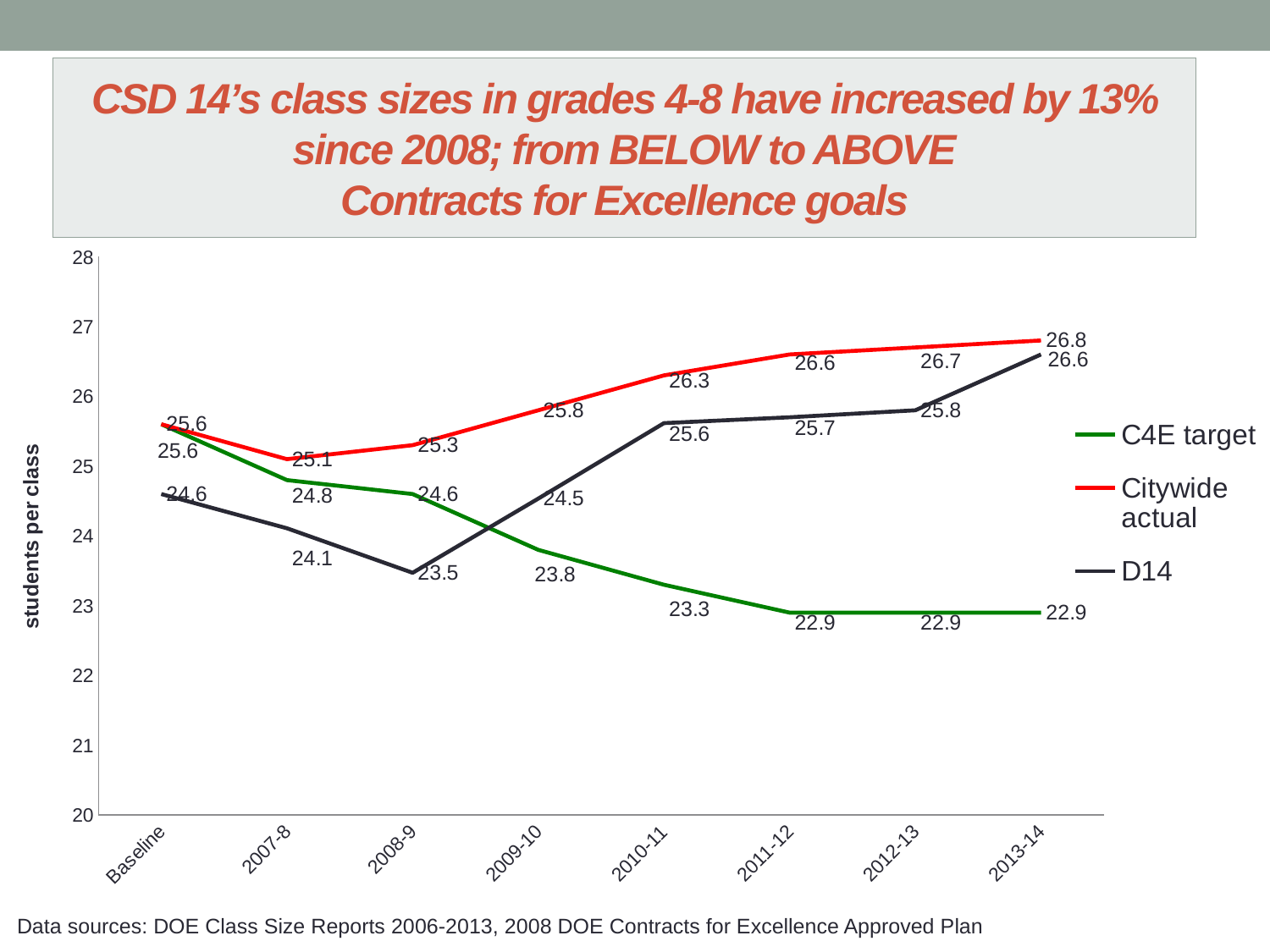
What is the C4E target value for 2009-10? 23.8 In which year is the D14 value lowest? 2008-9 What is the D14 value for 2013-14? 26.6 What kind of chart is shown on the slide? line chart How many points along the x axis does each line have? 8 In 2010-11, which is larger: Citywide actual or D14? Citywide actual What is the label on the y axis? students per class By how much did the D14 value increase from Baseline to 2013-14? 2.0 How many series does the legend list? 3 In which year is the Citywide actual value highest? 2013-14 Does the C4E target line rise or fall from Baseline to 2013-14? fall What is the Citywide actual value for 2011-12? 26.6